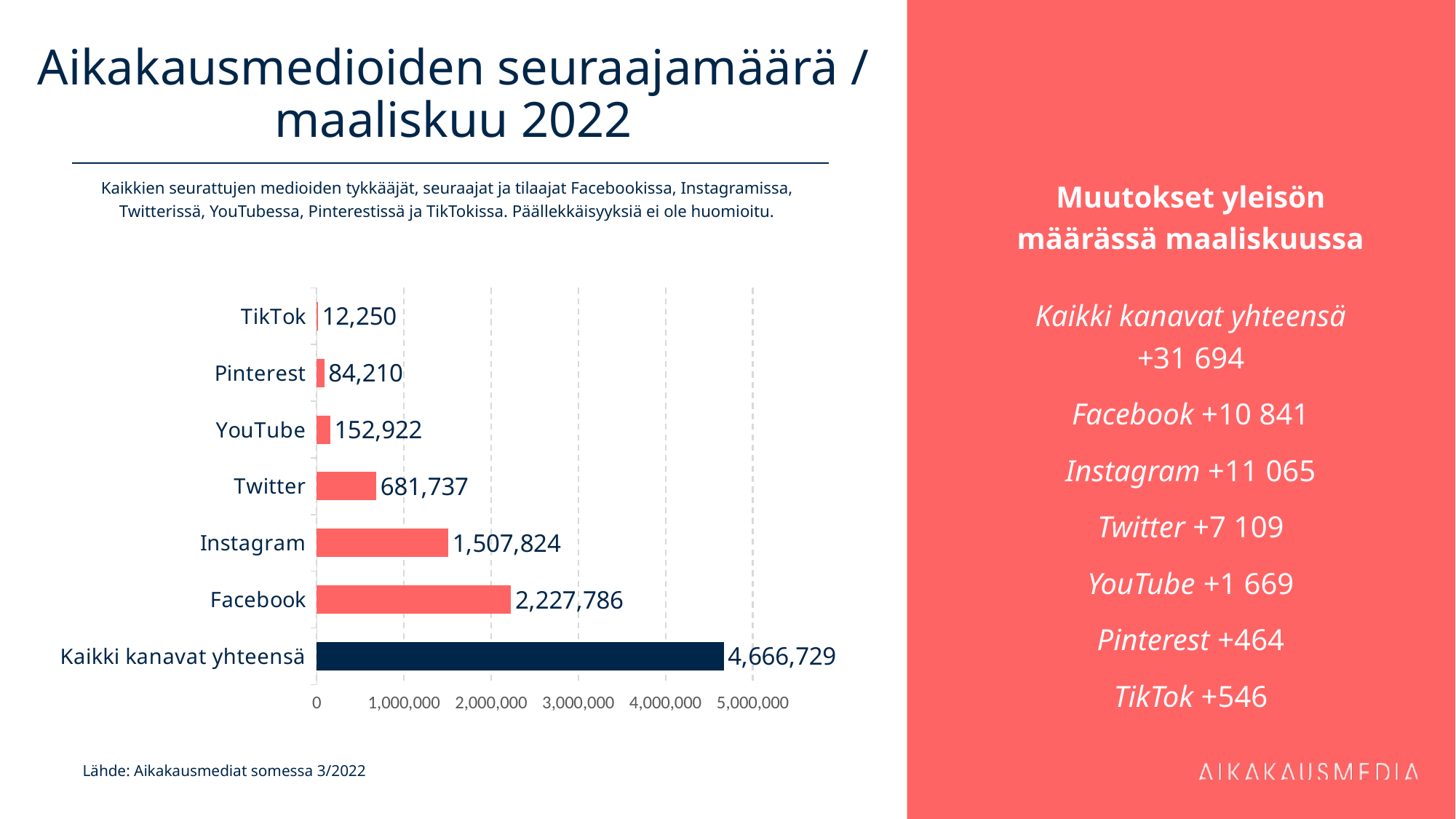
Which category has the lowest value? TikTok What is the value for Instagram? 1,507,824 What is the value for TikTok? 12,250 What is the difference between the values for Twitter and YouTube? 528,815 Which is larger, the value for Pinterest or the value for YouTube? YouTube Which individual channel (excluding the total bar) has the highest value? Facebook What is the difference between the values for Facebook and Instagram? 719,962 What is the value for Facebook? 2,227,786 What type of chart is shown on the slide? Bar chart What is the value for Kaikki kanavat yhteensä? 4,666,729 How many bars are shown in the chart? 7 What is the highest tick value shown on the horizontal axis? 5,000,000